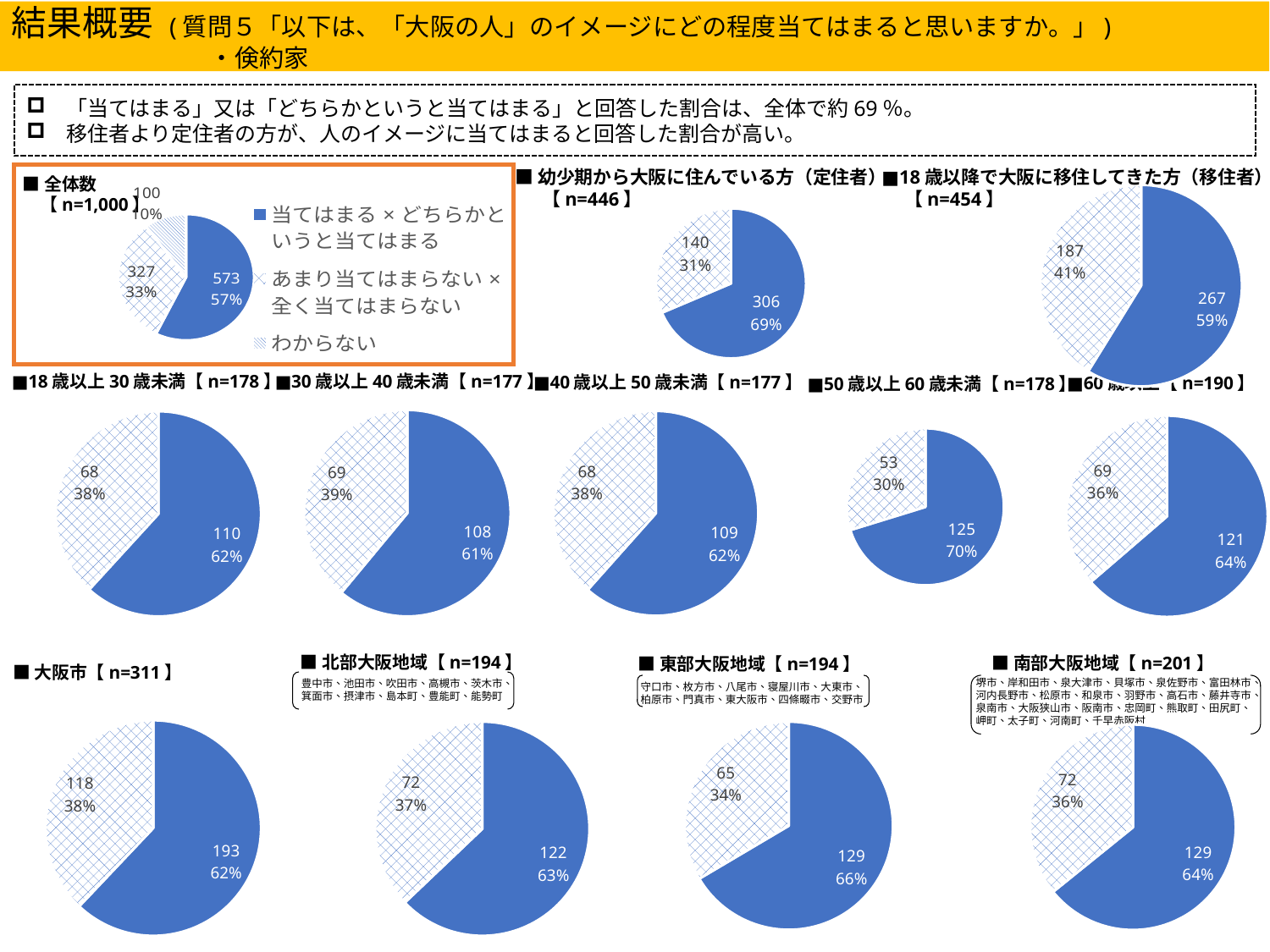
「東部大阪地域【n=194】」の円グラフで、青い区分の割合は何%ですか。 66% 「30歳以上40歳未満【n=177】」の円グラフで、2つの区分の値の差はいくつですか。 39 「南部大阪地域【n=201】」の円グラフは、いくつの区分に分かれていますか。 2 「全体数【n=1,000】」の円グラフの凡例には、いくつの項目がありますか。 3 「大阪市【n=311】」の円グラフで、青い区分の値はいくつですか。 193 「全体数【n=1,000】」の円グラフで、「当てはまる×どちらかというと当てはまる」の値はいくつですか。 573 「50歳以上60歳未満【n=178】」の円グラフで、青い区分の値と割合はいくつですか。 125、70% 「全体数【n=1,000】」の円グラフで、「わからない」の割合は何%ですか。 10% このスライドに使われているグラフの種類は何ですか。 円グラフ 「幼少期から大阪に住んでいる方（定住者）」と「18歳以降で大阪に移住してきた方（移住者）」の円グラフで、青い区分の割合が大きいのはどちらですか。 幼少期から大阪に住んでいる方（定住者） 「幼少期から大阪に住んでいる方（定住者）【n=446】」の円グラフで、大きい方の区分の割合は何%ですか。 69% 「18歳以降で大阪に移住してきた方（移住者）【n=454】」の円グラフで、小さい方の区分の値はいくつですか。 187